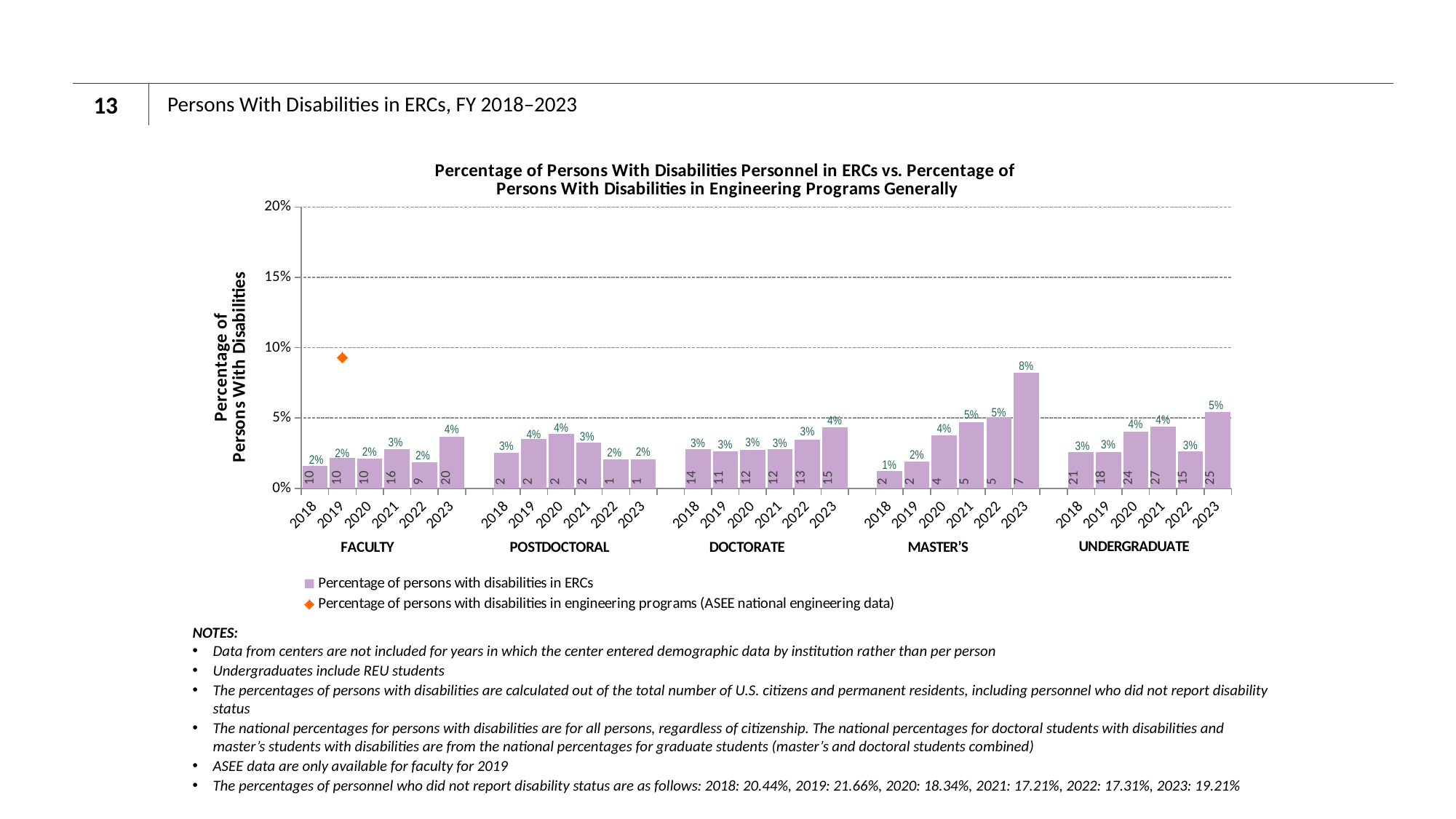
What number is printed inside the Faculty bar for 2021? 16 Which group and year has the highest percentage of persons with disabilities in ERCs? Master's, 2023 What kind of chart is shown on the slide? Bar chart Is the value of the orange diamond (ASEE national engineering data) for Faculty in 2019 greater or less than 5%? greater What is the percentage of persons with disabilities in ERCs for Undergraduates in 2023? 5% What is the difference in percentage points between the Master's value in 2023 and the Master's value in 2018? 7 percentage points How many series does the legend list? 2 What is the percentage of persons with disabilities in ERCs for Master's students in 2023? 8% Which group and year has the lowest percentage of persons with disabilities in ERCs? Master's, 2018 Which is larger: the 2023 percentage for Master's or the 2023 percentage for Undergraduate? Master's Do the Master's percentages rise or fall from 2018 to 2023? rise How many years are shown for each personnel group? 6